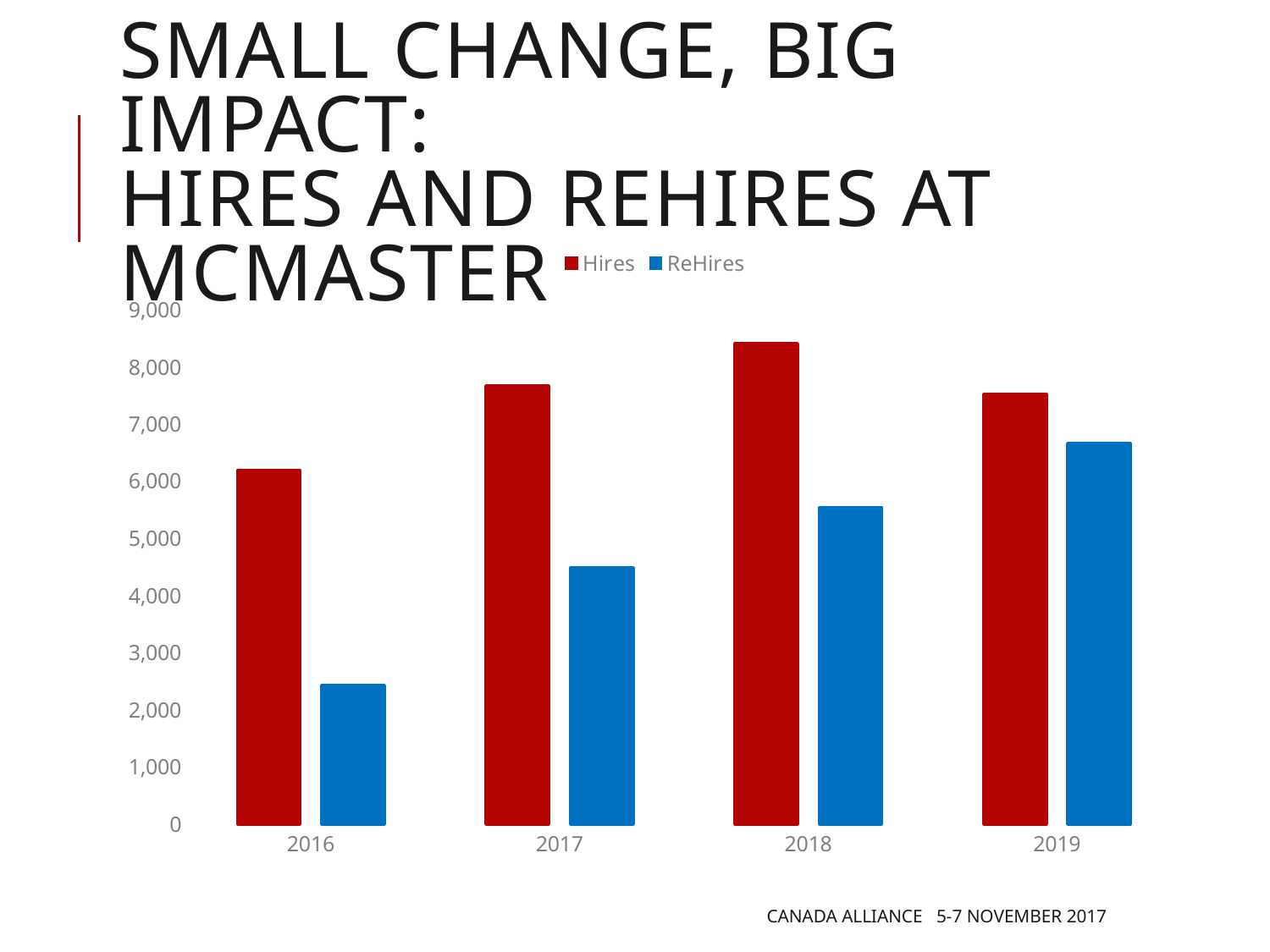
What colour are the bars for the ReHires series? blue What kind of chart is shown on the slide? bar chart How many series does the chart's legend list? 2 Which year has the lowest value for ReHires? 2016 Which year has the highest value for Hires? 2018 Is the value for ReHires in 2019 greater or less than 6,000? greater Is the value for Hires in 2018 greater or less than 8,000? greater Is the value for ReHires in 2016 greater or less than 3,000? less Do the ReHires values rise or fall from 2016 to 2019? rise How many years are shown on the x axis of the chart? 4 In 2019, which is larger, Hires or ReHires? Hires Which year has the lowest value for Hires? 2016